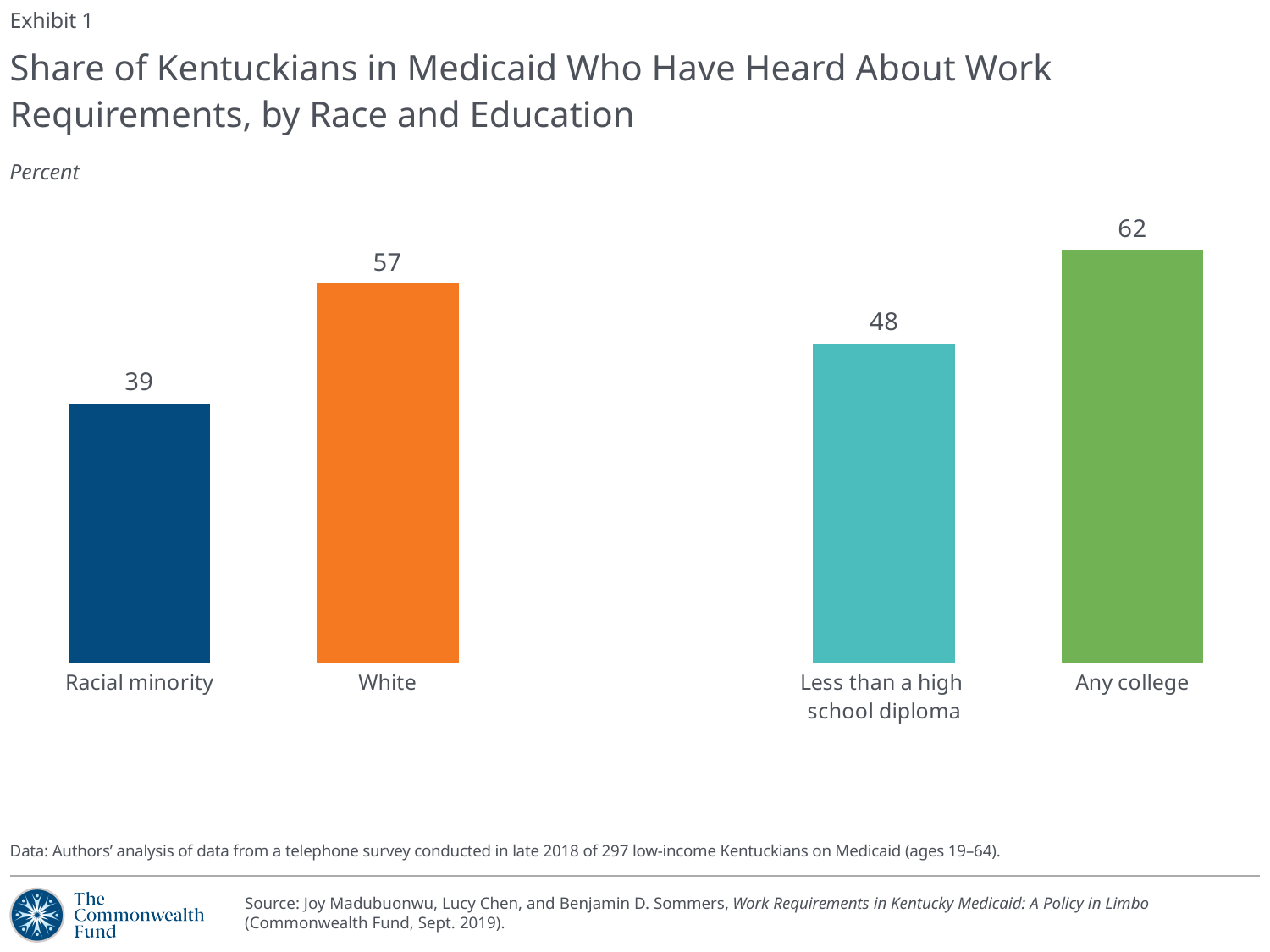
What is the value for White? 57 Which category has the lowest value? Racial minority What is the difference between the values for White and Racial minority? 18 What kind of chart is shown on the slide? Bar chart What is the value for Less than a high school diploma? 48 Which category has the highest value? Any college What is the difference between the values for Any college and Less than a high school diploma? 14 What is the value for Any college? 62 Which is larger, the value for White or the value for Less than a high school diploma? White What unit is the chart measured in, according to the label under the title? Percent How many categories are shown in the chart? 4 What is the value for Racial minority? 39